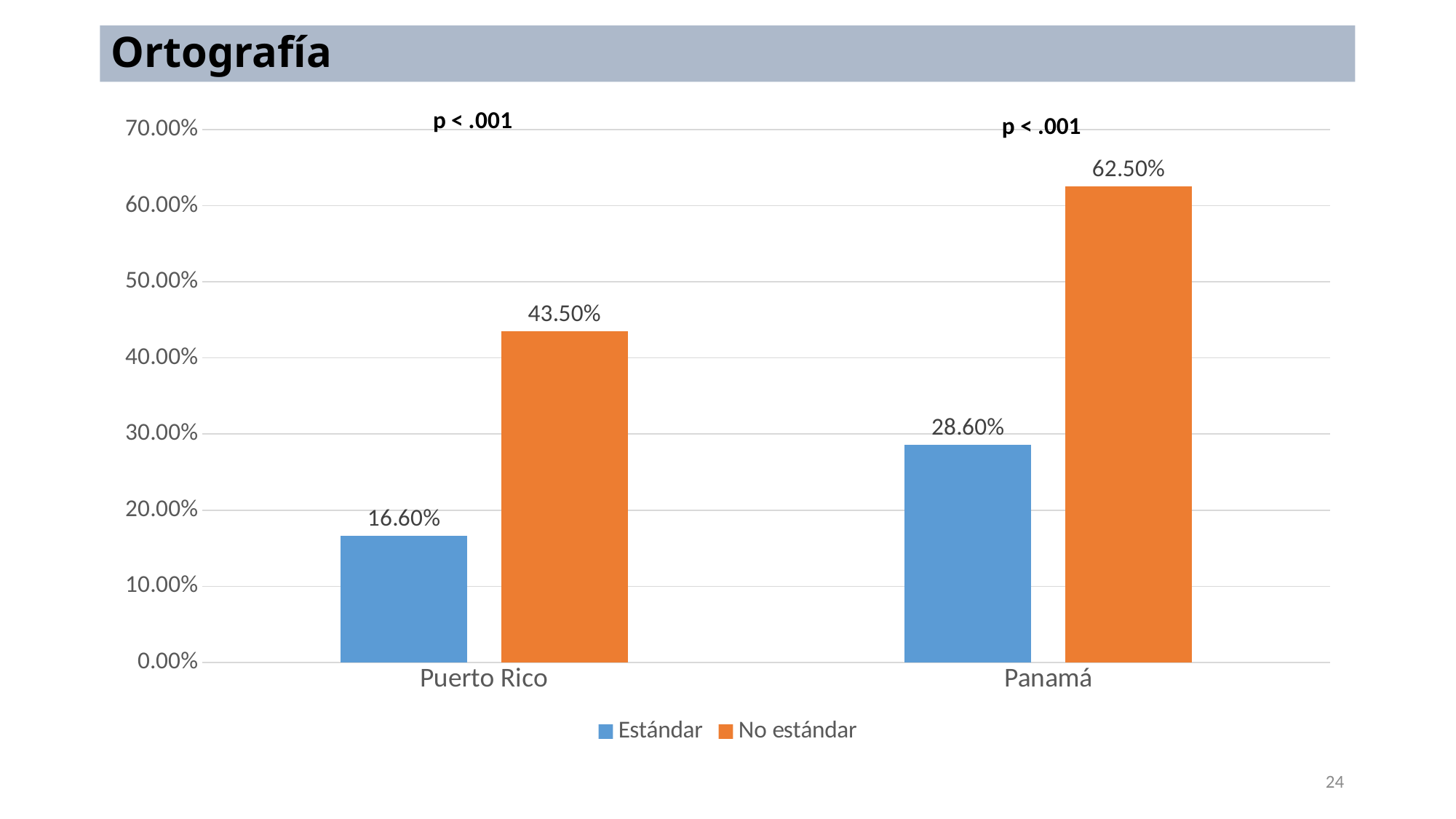
What is the value for No estándar in Puerto Rico? 43.50% Which is larger: the No estándar value for Puerto Rico or the Estándar value for Panamá? No estándar value for Puerto Rico How many series does the legend list? 2 Which country has the lowest Estándar value? Puerto Rico What is the value for No estándar in Panamá? 62.50% What is the difference between the Estándar values for Panamá and Puerto Rico? 12.00% Which country has the highest No estándar value? Panamá What kind of chart is shown on the slide? Bar chart What is the value for Estándar in Panamá? 28.60% What is the difference between the No estándar and Estándar values for Panamá? 33.90% What is the value for Estándar in Puerto Rico? 16.60% How many countries are shown on the x axis? 2